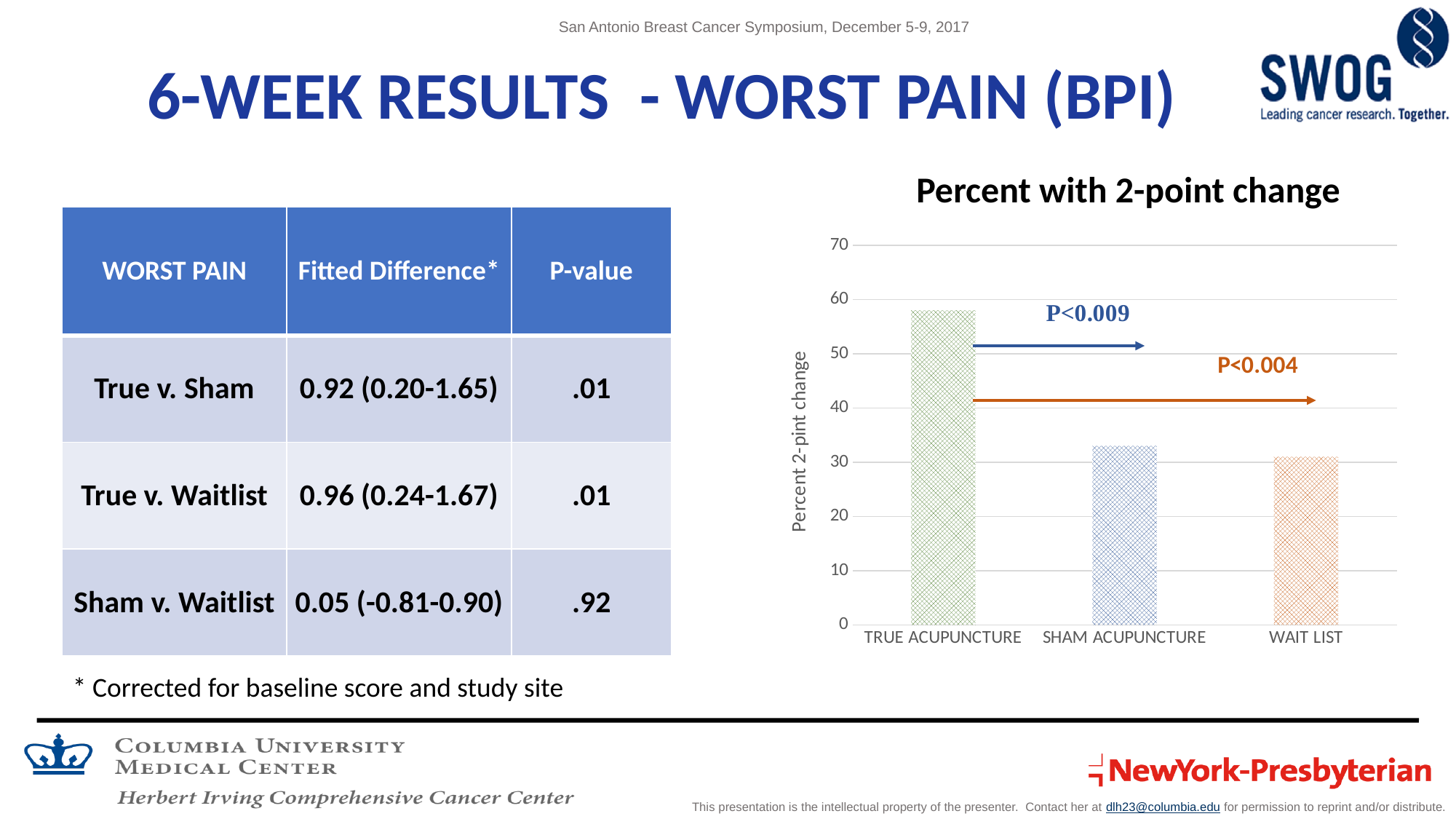
What is the label on the vertical axis of the chart? Percent 2-pint change Which is larger, the value for TRUE ACUPUNCTURE or the value for WAIT LIST? TRUE ACUPUNCTURE Is the value for WAIT LIST greater or less than 20? greater Is the value for WAIT LIST greater or less than 40? less What kind of chart is shown on the slide? bar chart Is the value for TRUE ACUPUNCTURE greater or less than 60? less How many categories are plotted in the chart? 3 What is the title of the chart on the slide? Percent with 2-point change Which category has the highest value in the chart? TRUE ACUPUNCTURE